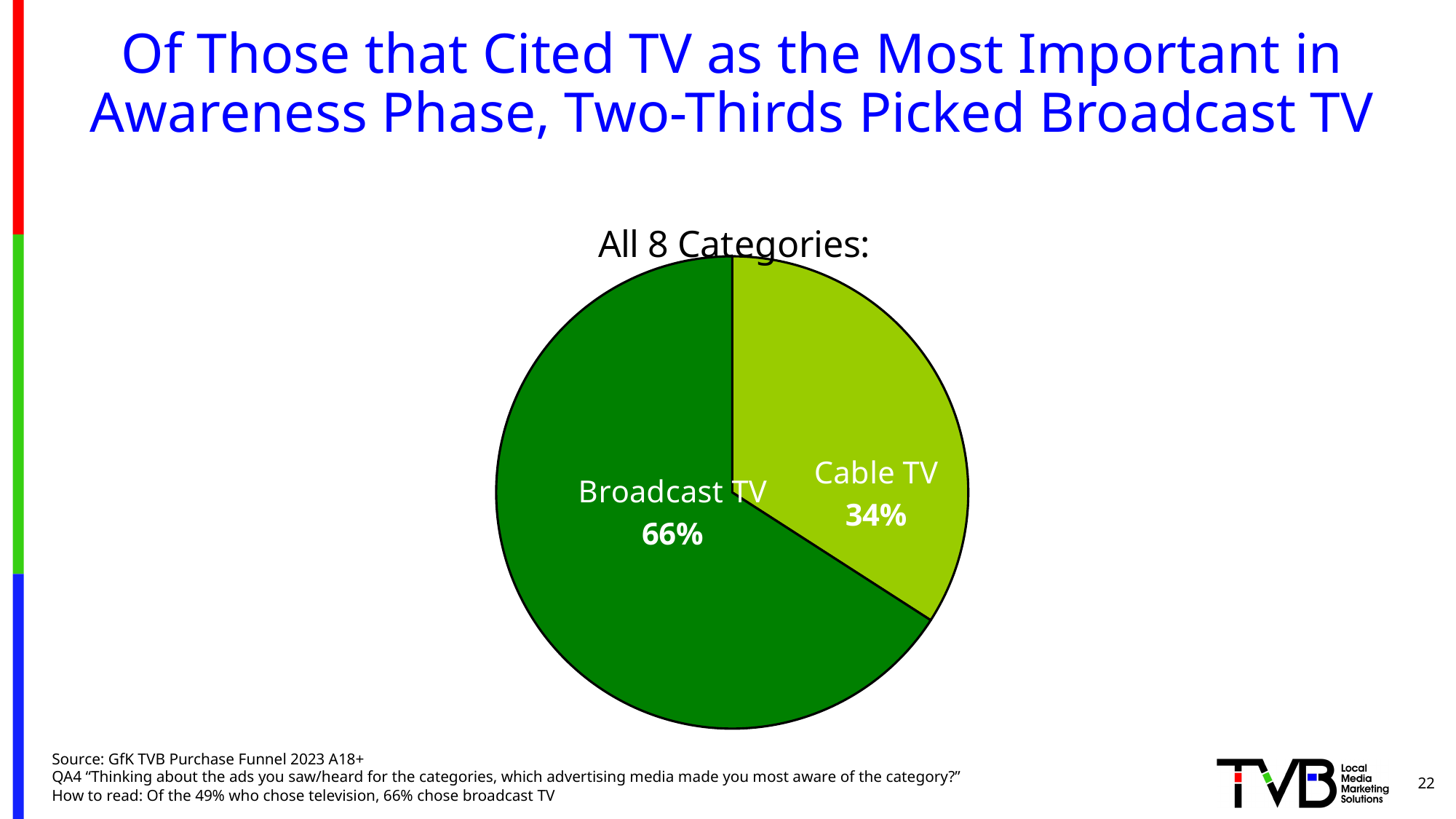
Which slice of the pie is the largest? Broadcast TV What is the difference in percentage points between Broadcast TV and Cable TV? 32 Which slice of the pie is the smallest? Cable TV What is the title shown above the pie chart? All 8 Categories: What share of the pie does Cable TV have? 34% What colour is the Cable TV slice? light green How many slices does the pie chart have? 2 What kind of chart is shown on the slide? pie chart Is the value for Cable TV greater or less than 50%? less What share of the pie does Broadcast TV have? 66% Which is larger, the Broadcast TV slice or the Cable TV slice? Broadcast TV